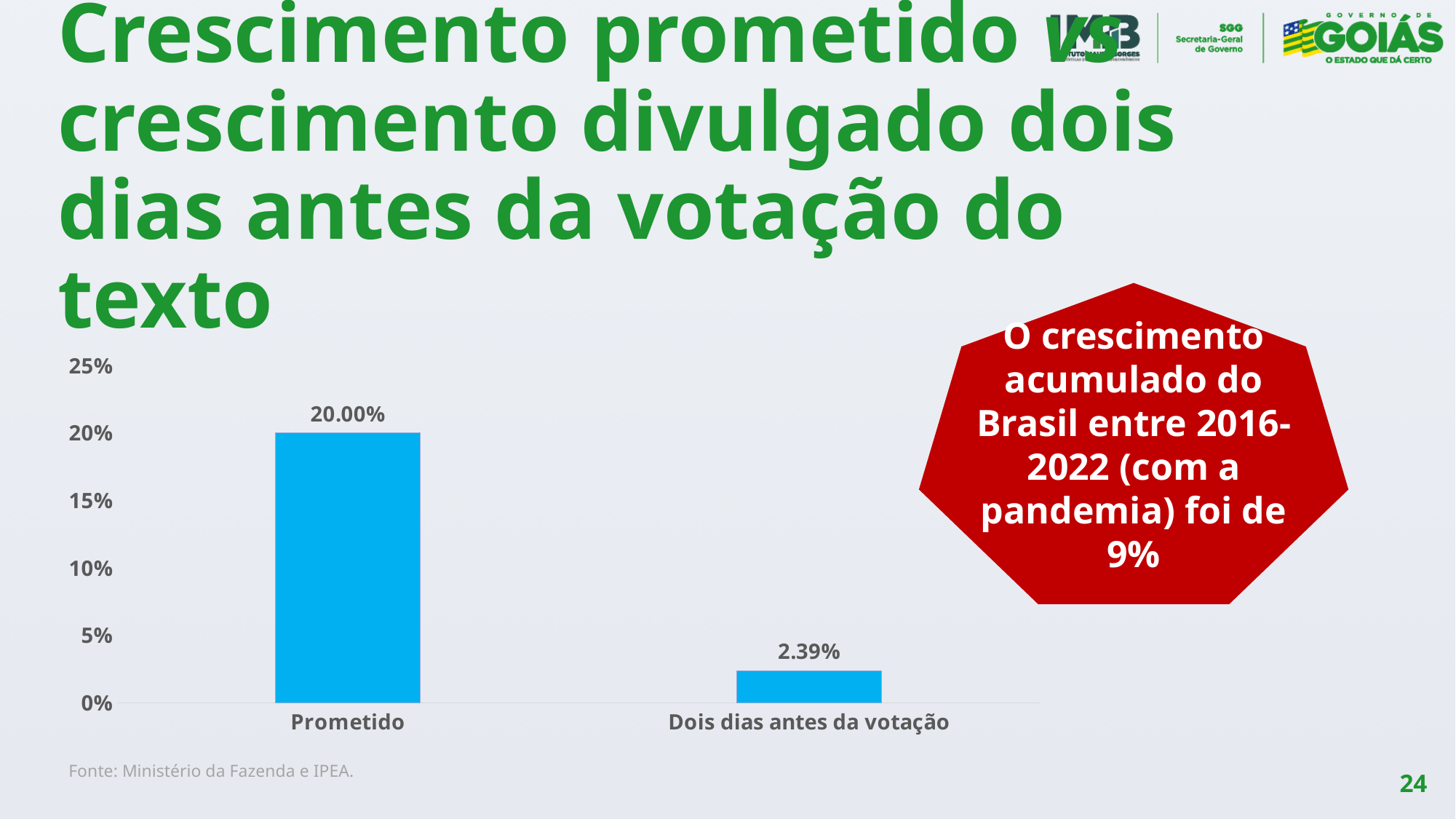
What is the maximum value shown on the vertical axis? 25% Which category has the highest value? Prometido How many categories are shown in the chart? 2 What is the value for Dois dias antes da votação? 2.39% Which category has the lowest value? Dois dias antes da votação Is the value for Dois dias antes da votação greater or less than 5%? less What kind of chart is shown on the slide? bar chart Which is larger, the value for Prometido or the value for Dois dias antes da votação? Prometido What is the difference between the Prometido value and the Dois dias antes da votação value? 17.61% Is the value for Prometido greater or less than 15%? greater What colour are the bars in the chart? blue What is the value for Prometido? 20.00%